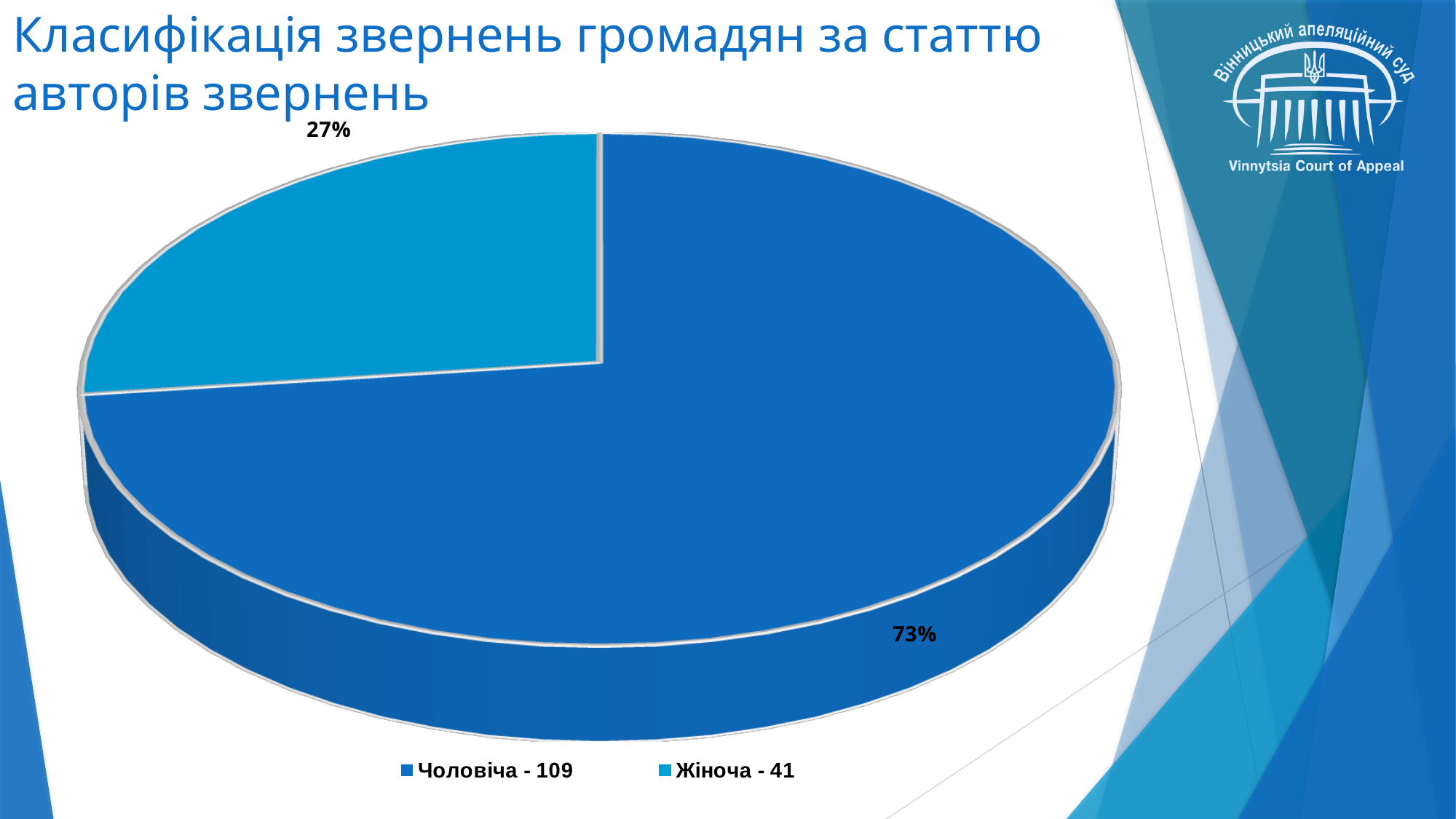
What percentage share does the "Чоловіча - 109" slice have? 73% How many slices does the pie chart have? 2 What percentage share does the "Жіноча - 41" slice have? 27% What count is shown in the legend for "Чоловіча"? 109 What count is shown in the legend for "Жіноча"? 41 How many entries does the legend list? 2 Which slice is the smallest? Жіноча - 41 What colour is the "Жіноча - 41" slice? light blue Which slice is the largest? Чоловіча - 109 What is the difference in percentage points between the "Чоловіча" and "Жіноча" slices? 46 Which is larger, the "Чоловіча" slice or the "Жіноча" slice? Чоловіча What kind of chart is shown on the slide? pie chart